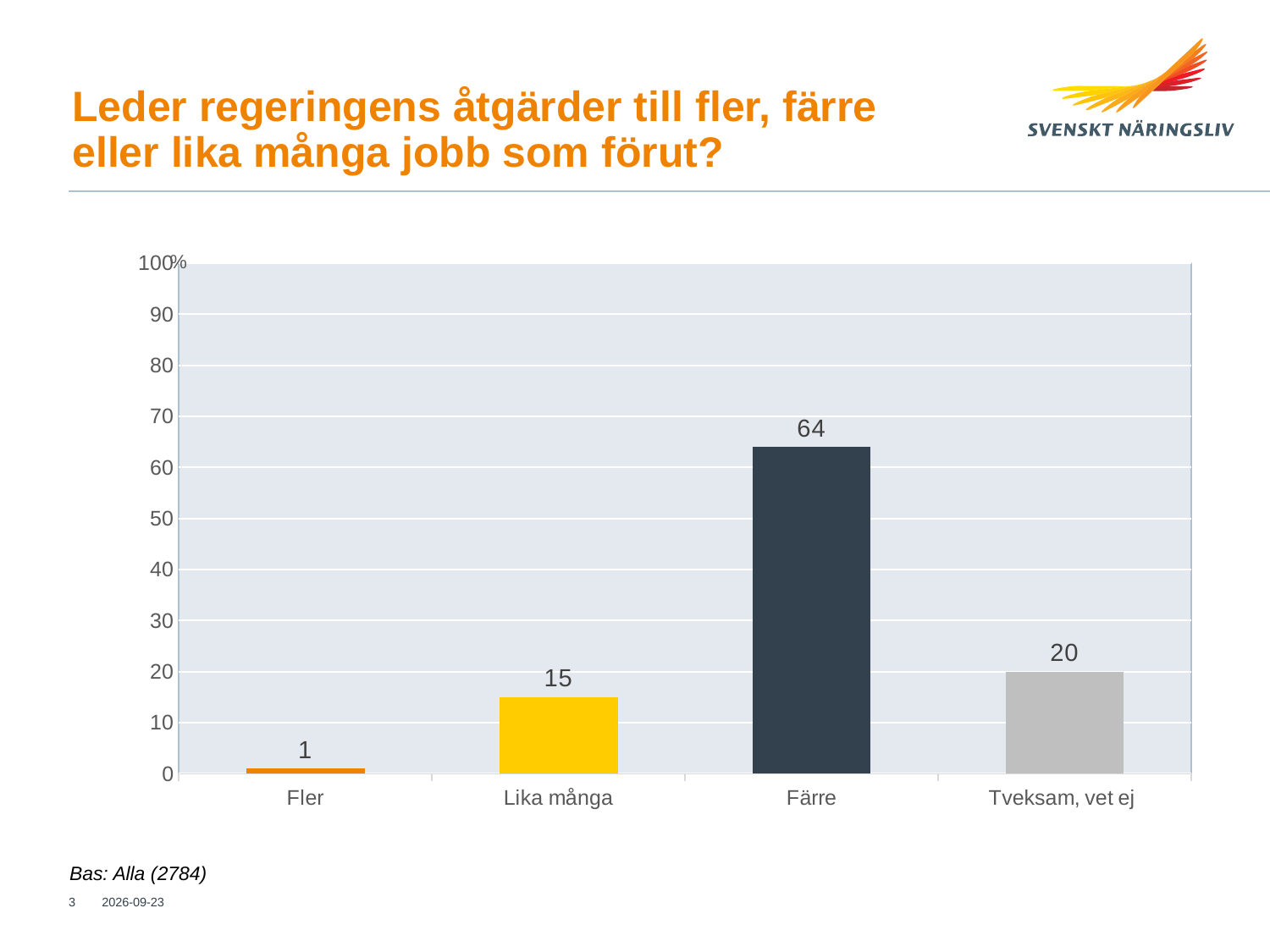
What is the difference between the values for Färre and Tveksam, vet ej? 44 What is the value for Fler? 1 What kind of chart is shown on the slide? bar chart How many categories are shown on the x axis? 4 What is the value for Lika många? 15 What is the value for Tveksam, vet ej? 20 Which is larger, the value for Lika många or the value for Tveksam, vet ej? Tveksam, vet ej What is the base (Bas) stated below the chart? Alla (2784) What is the value for Färre? 64 Which category has the highest value? Färre Which category has the lowest value? Fler Is the value for Färre greater or less than 50? greater